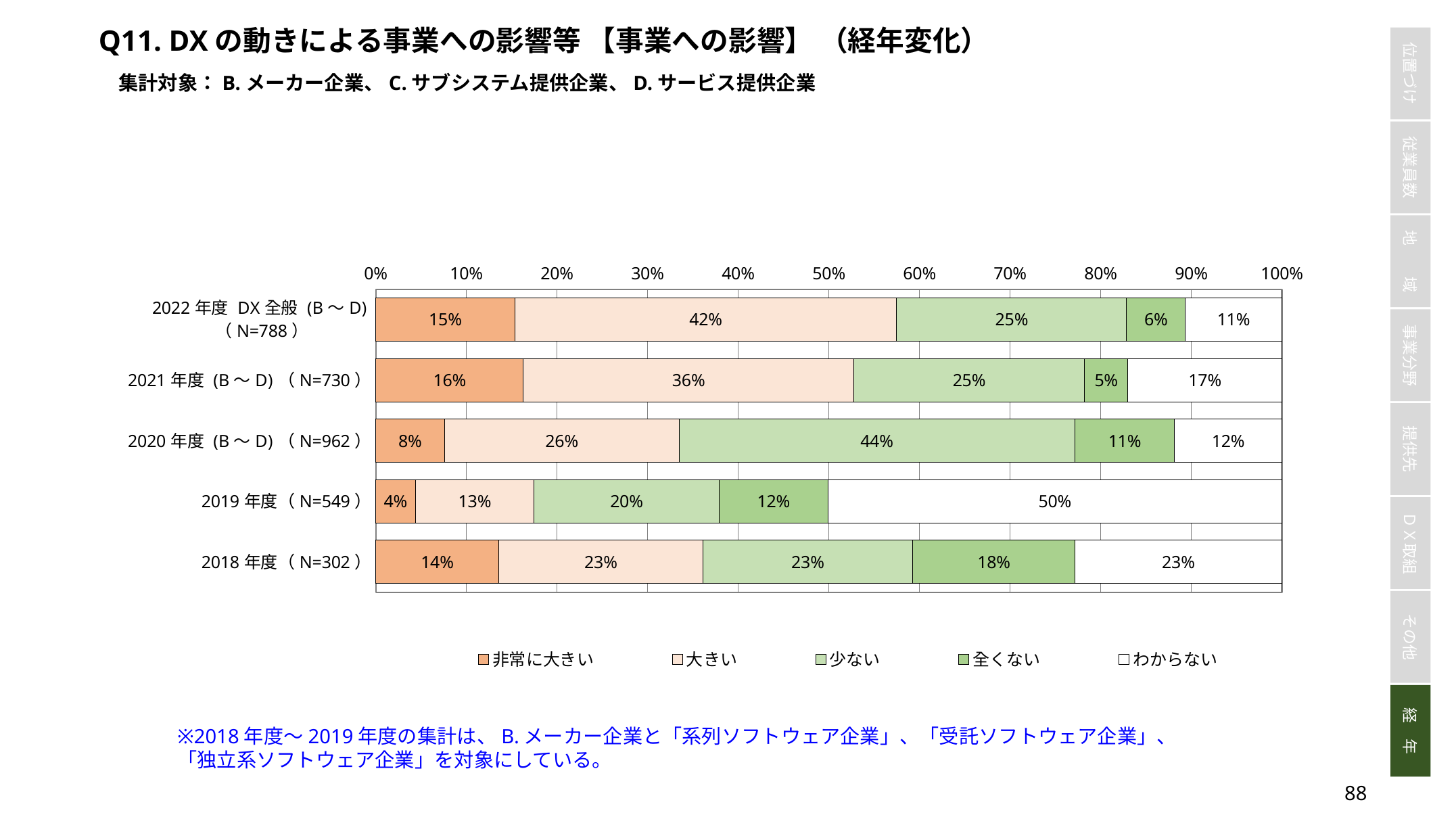
What is the value of 「全くない」 for 2018年度（N=302）? 18% What is the value of 「少ない」 for 2020年度（B～D）（N=962）? 44% What kind of chart is shown on the slide? Stacked bar chart How many series does the legend list? 5 What is the difference between the 「わからない」 values for 2021年度 and 2022年度? 6% What is the value of 「わからない」 for 2019年度（N=549）? 50% What is the value of 「大きい」 for 2022年度 DX全般（B～D）（N=788）? 42% How many year categories are plotted on the chart? 5 Which year has the highest value for 「非常に大きい」? 2021年度（B～D）（N=730） What is the combined share of 「非常に大きい」 and 「大きい」 for 2022年度 DX全般（B～D）? 57% Which is larger: the 「少ない」 value for 2020年度 or for 2021年度? 2020年度 Which year has the lowest value for 「大きい」? 2019年度（N=549）